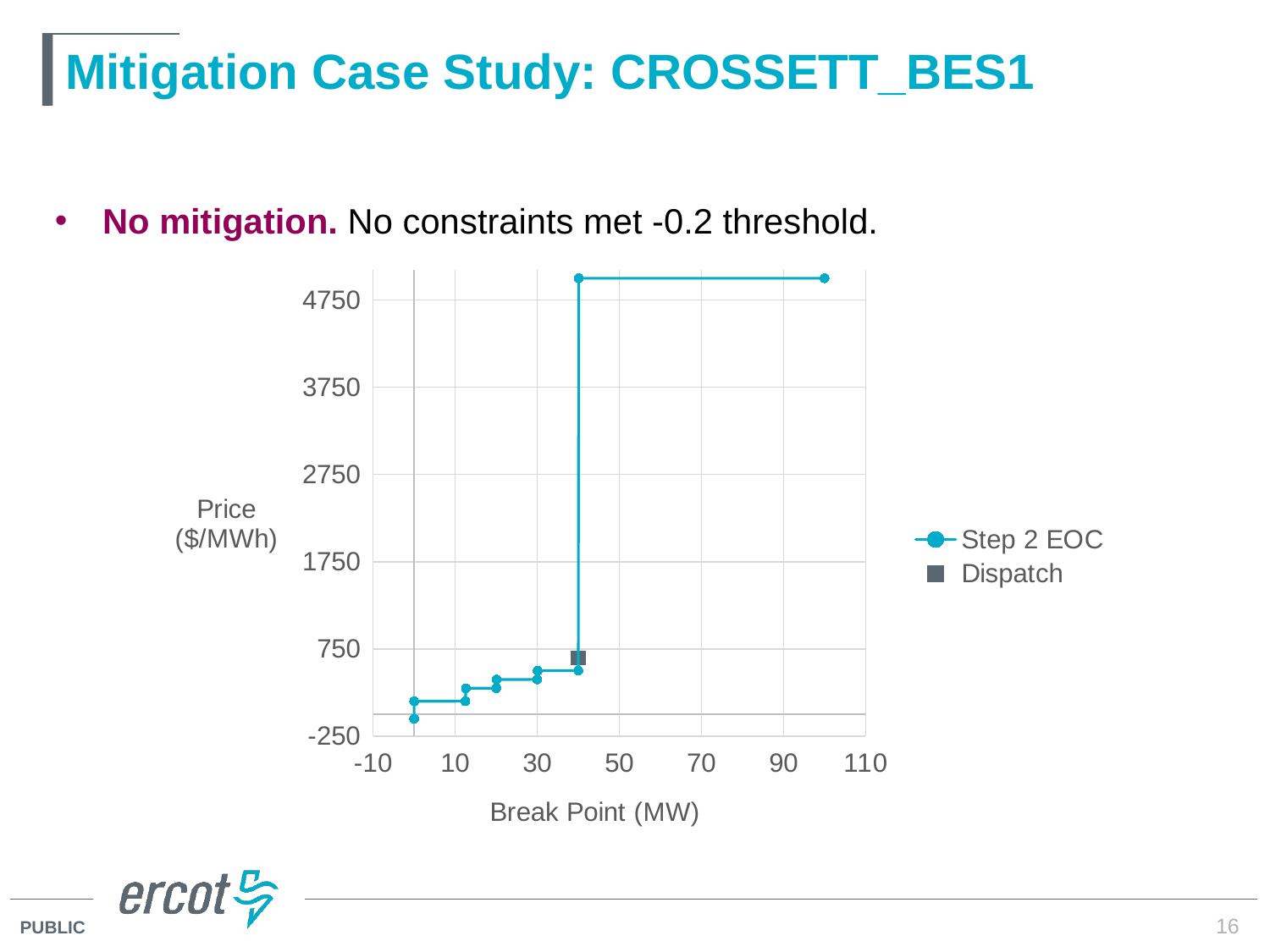
Does the Step 2 EOC price rise or fall as the break point increases? rise Is the Step 2 EOC price at a break point of 100 MW greater or less than 4750? greater Is the Step 2 EOC price at a break point of 30 MW greater or less than 1750? less How many series does the legend list? 2 What are the two series named in the legend? Step 2 EOC and Dispatch Is the Step 2 EOC price at a break point of 0 MW greater or less than 750? less What kind of chart is shown on the slide? line chart Is the Step 2 EOC price at a break point of 100 MW greater or less than the price at a break point of 0 MW? greater What is the label of the x axis? Break Point (MW)